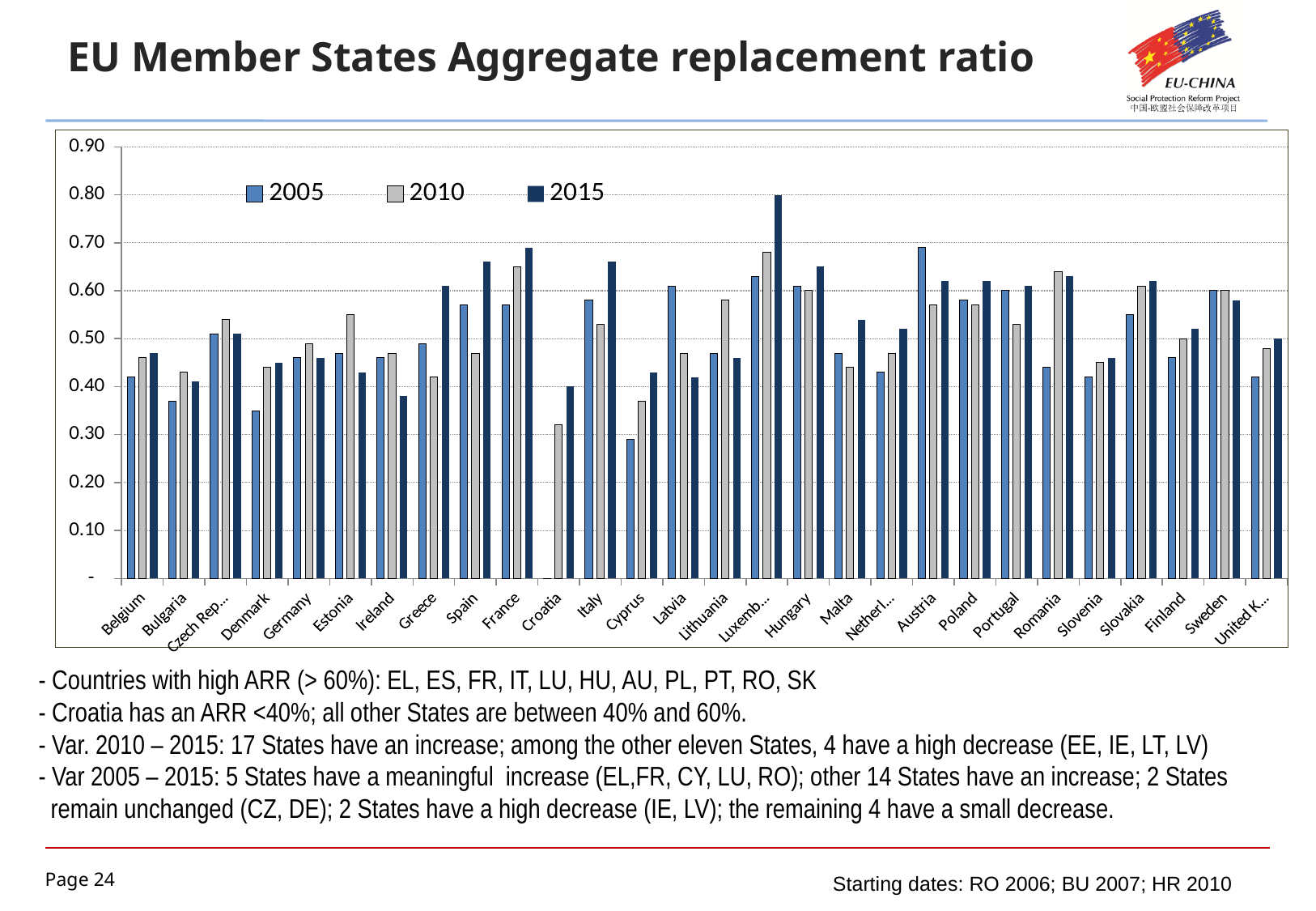
How many countries are shown on the x axis? 28 What kind of chart is shown on the slide? bar chart Do the values for Latvia rise or fall from 2005 to 2015? fall Is the 2015 value for Luxembourg greater or less than 0.70? greater Is the 2010 value for Croatia greater or less than 0.40? less Is the 2005 value for Austria greater or less than 0.60? greater Which country has the highest 2015 bar? Luxembourg Which years are listed in the legend? 2005, 2010, 2015 How many series does the legend list? 3 Which is larger for Austria: the 2005 value or the 2010 value? 2005 Which country has the lowest 2005 bar? Cyprus